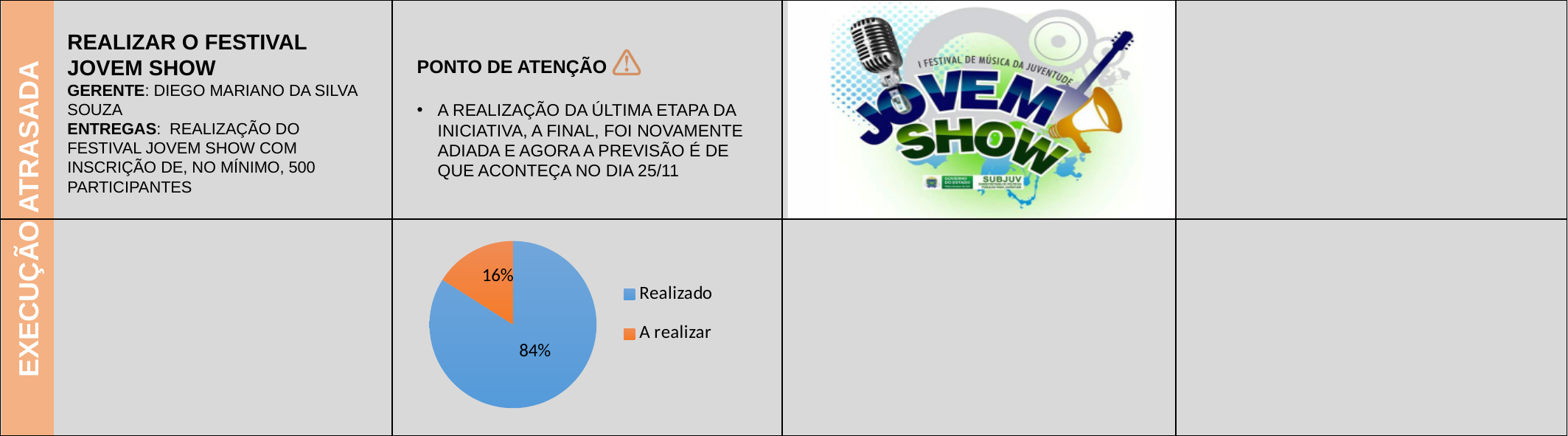
What is the value for Realizado in the pie chart? 84% What colour is the Realizado slice in the pie chart? blue What is the value for A realizar in the pie chart? 16% What colour is the A realizar slice in the pie chart? orange Which slice of the pie chart is the smallest? A realizar What share of the pie does the A realizar slice represent? 16% Which slice of the pie chart is the largest? Realizado Which is larger, Realizado or A realizar? Realizado What is the difference between the Realizado and A realizar slices? 68% How many entries does the legend of the pie chart list? 2 What kind of chart is shown on the slide? pie chart How many slices does the pie chart have? 2